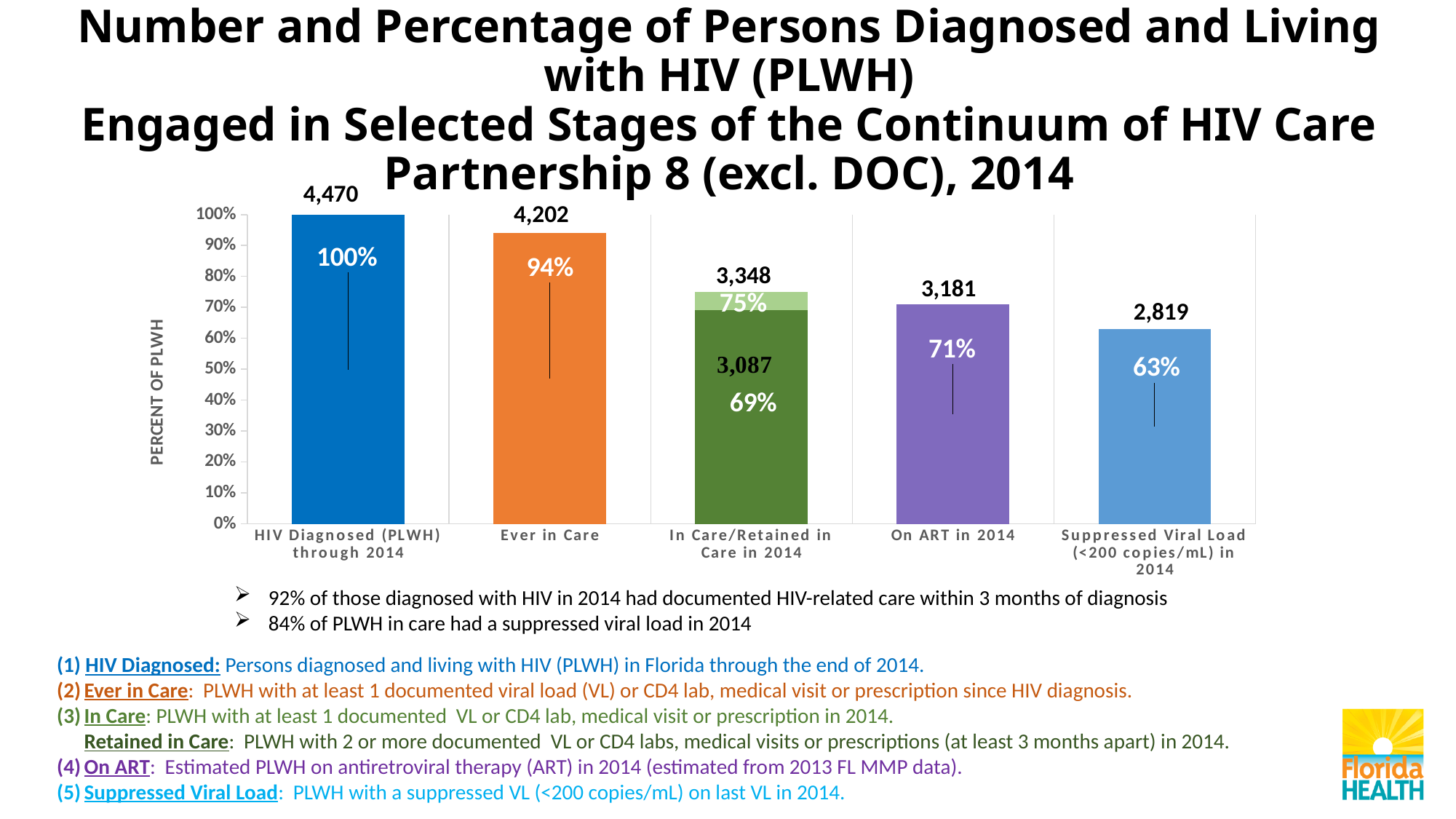
What percentage is shown for the darker green 'Retained in Care' portion of the 'In Care/Retained in Care in 2014' bar? 69% What kind of chart is shown on the slide? bar chart What percentage is shown for the 'Ever in Care' bar? 94% What number is labelled at the top of the 'In Care/Retained in Care in 2014' bar? 3,348 Which category has the lowest value in the chart? Suppressed Viral Load (<200 copies/mL) in 2014 What is the difference in number of persons between 'HIV Diagnosed (PLWH) through 2014' and 'Ever in Care'? 268 How many categories are shown on the x axis of the chart? 5 Which is larger, the value for 'On ART in 2014' or the value for 'Suppressed Viral Load (<200 copies/mL) in 2014'? On ART in 2014 What is the number of persons labelled for the 'On ART in 2014' bar? 3,181 What is the number of persons labelled for the 'HIV Diagnosed (PLWH) through 2014' bar? 4,470 What percentage is shown for the 'Suppressed Viral Load (<200 copies/mL) in 2014' bar? 63% Which category has the highest value in the chart? HIV Diagnosed (PLWH) through 2014